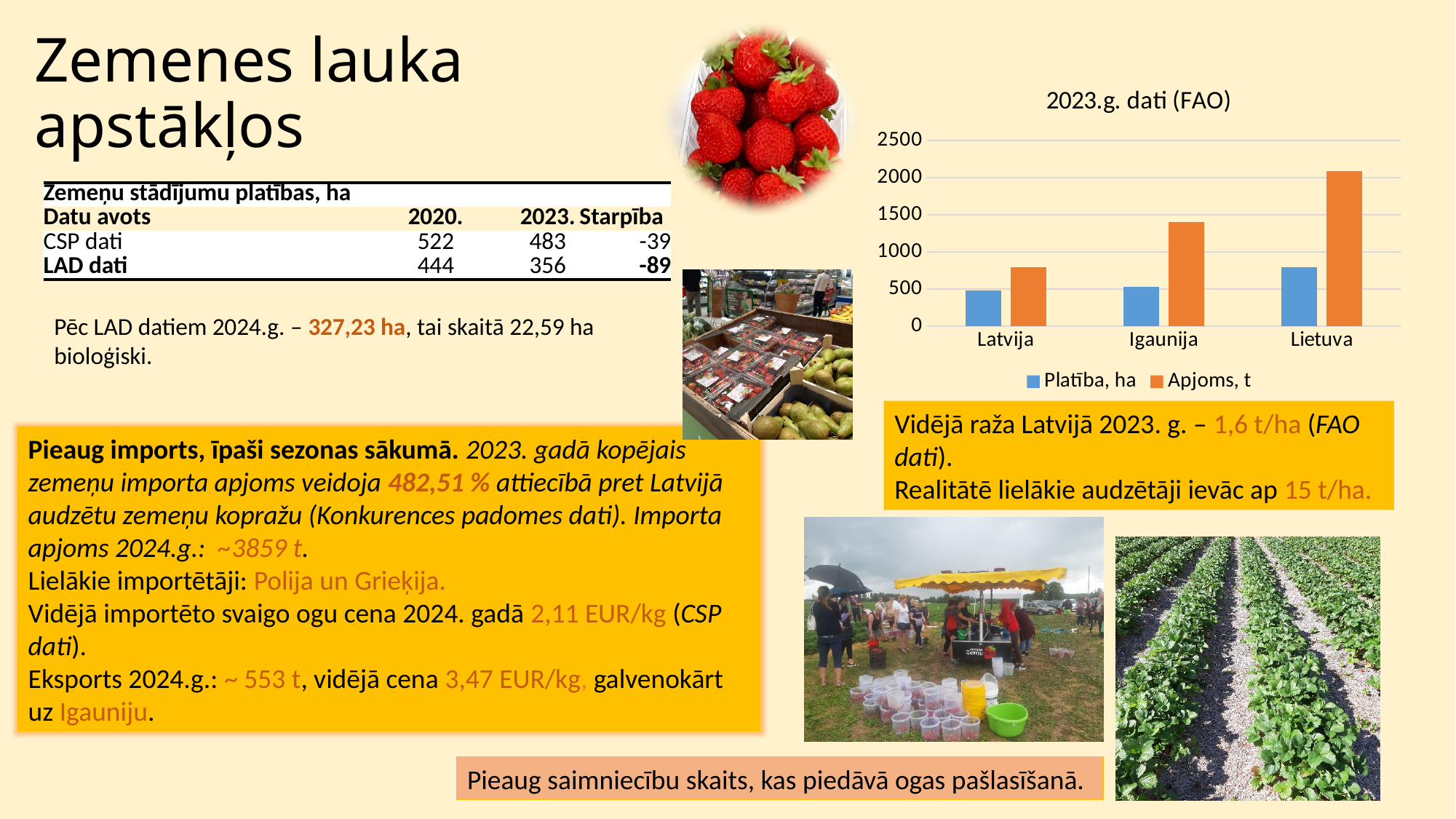
Which country has the highest "Platība, ha" value in the "2023.g. dati (FAO)" chart? Lietuva How many series does the legend of the "2023.g. dati (FAO)" chart list? 2 In the "2023.g. dati (FAO)" chart, is the "Apjoms, t" value for Lietuva larger or smaller than that for Igaunija? larger In the "2023.g. dati (FAO)" chart, is the "Apjoms, t" value for Igaunija greater or less than 1000? greater Which country has the lowest "Apjoms, t" value in the "2023.g. dati (FAO)" chart? Latvija What is the title of the bar chart on the slide? 2023.g. dati (FAO) What kind of chart is shown under the title "2023.g. dati (FAO)"? bar chart How many countries are shown on the x axis of the "2023.g. dati (FAO)" chart? 3 Which colour represents the "Apjoms, t" series in the "2023.g. dati (FAO)" chart? orange Which country has the highest "Apjoms, t" value in the "2023.g. dati (FAO)" chart? Lietuva In the "2023.g. dati (FAO)" chart, is the "Platība, ha" value for Lietuva greater or less than 500? greater In the "2023.g. dati (FAO)" chart, is the "Apjoms, t" value for Latvija greater or less than 1000? less